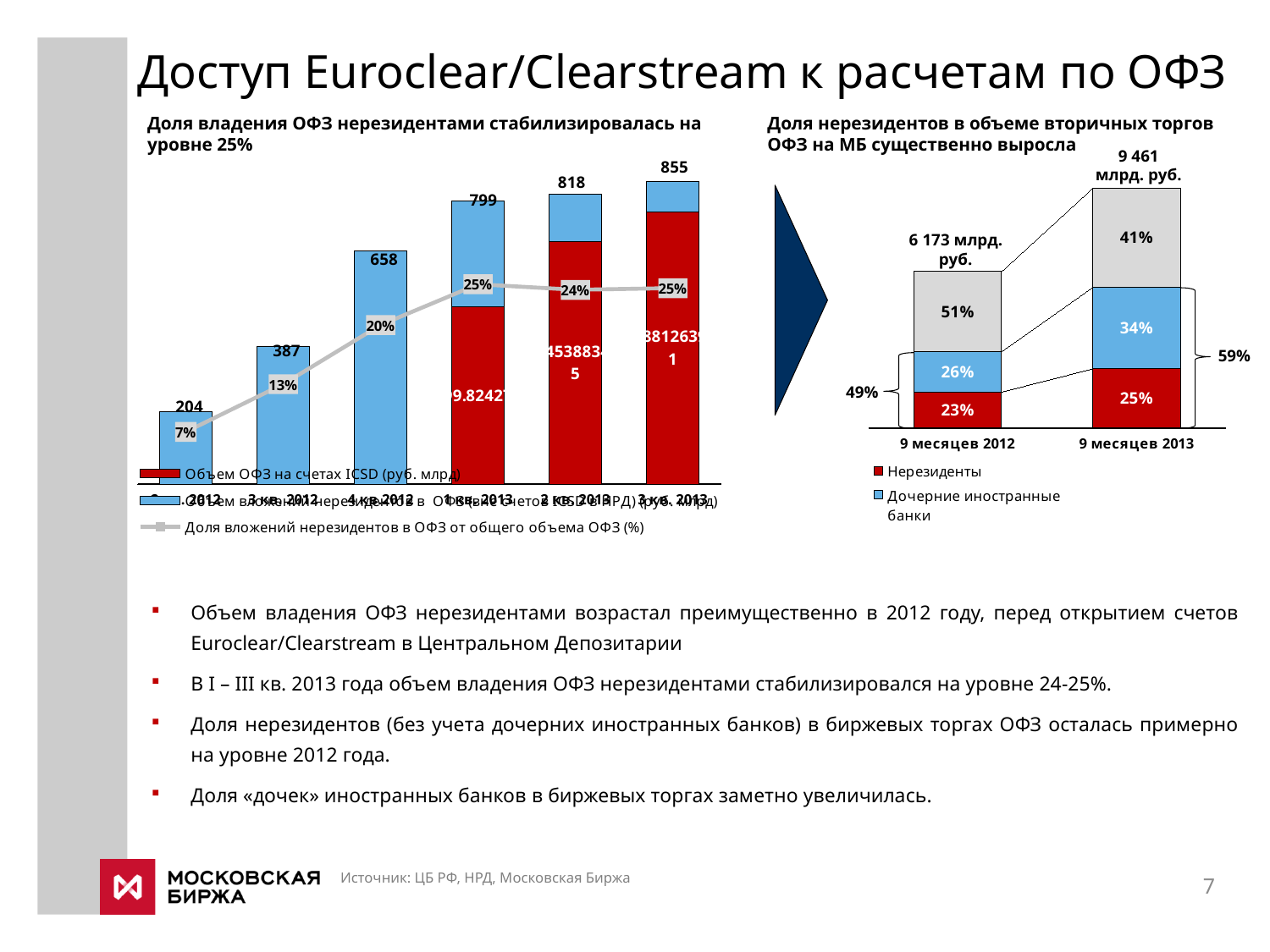
On the left chart, what share percentage is shown on the line for the first (leftmost) bar? 7% On the left chart, what is the total value labelled above the tallest bar? 855 On the right chart, what is the combined share of the red and blue segments for 9 месяцев 2013, as shown by the bracket label? 59% On the right chart, which period has the larger blue 'Дочерние иностранные банки' share: 9 месяцев 2012 or 9 месяцев 2013? 9 месяцев 2013 On the right chart, what total volume in млрд. руб. is labelled above the 9 месяцев 2013 bar? 9 461 млрд. руб. On the right chart, what is the share of 'Нерезиденты' (red segment) for 9 месяцев 2013? 25% On the right chart, what is the share of 'Дочерние иностранные банки' (blue segment) for 9 месяцев 2012? 26% On the left chart, how many series does the legend list? 3 On the left chart, how many stacked bars are plotted? 6 On the left chart, what is the difference between the totals of the last bar (855) and the first bar (204)? 651 On the left chart, do the bar totals generally rise or fall from left to right? rise On the left chart, what is the total value labelled above the first (leftmost) bar? 204